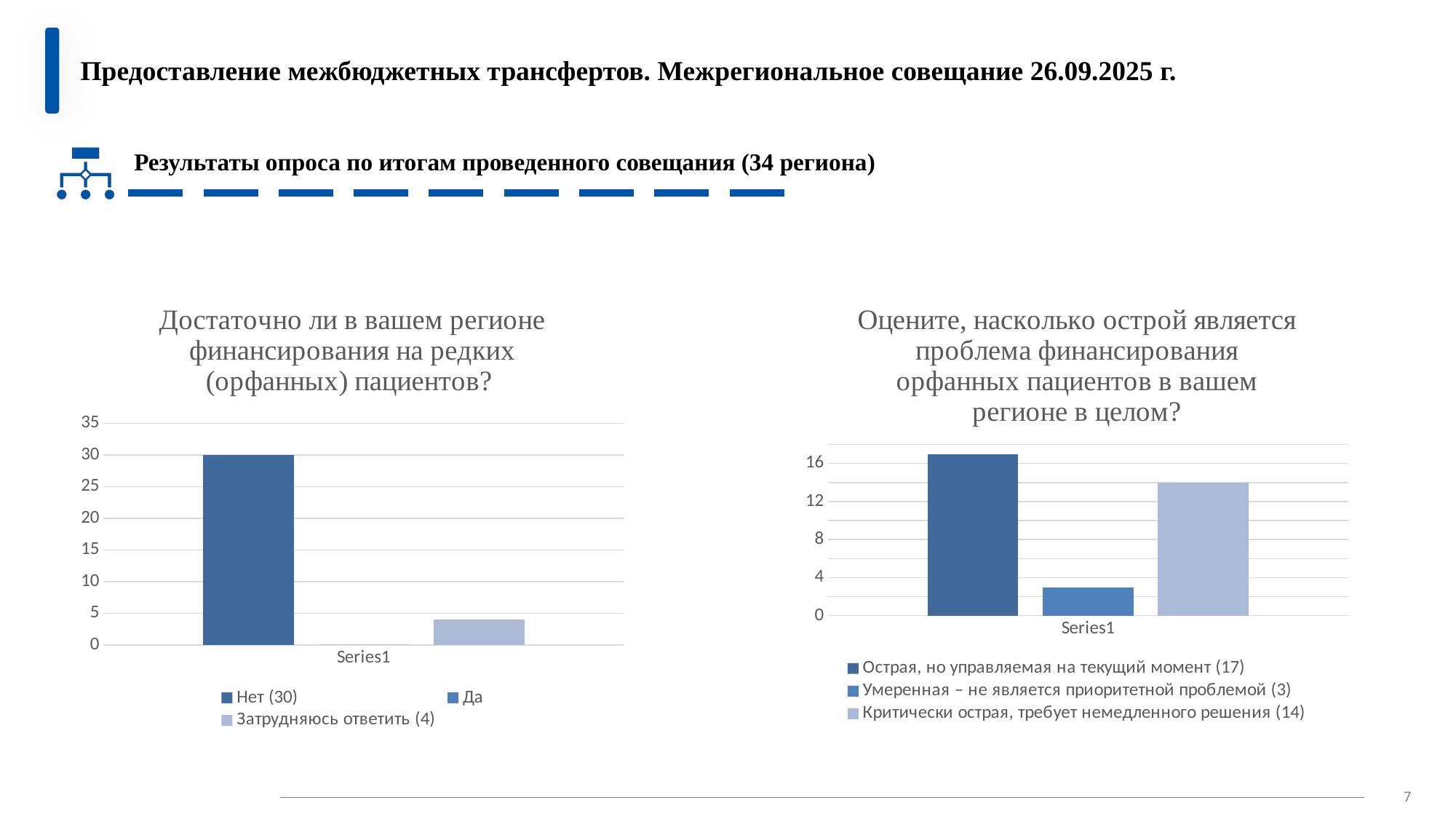
In the left chart ("Достаточно ли в вашем регионе финансирования..."), how many regions answered "Нет"? 30 In the right chart, is the value for "Острая, но управляемая на текущий момент" greater or less than 16? greater In the right chart, how many regions chose "Критически острая, требует немедленного решения"? 14 In the left chart, how many regions answered "Затрудняюсь ответить"? 4 In the right chart, what is the difference between the "Острая, но управляемая" value and the "Умеренная" value? 14 In the left chart, what is the difference between the "Нет" and "Затрудняюсь ответить" values? 26 What type of chart is the left chart? bar chart In the left chart, which answer has the highest value? Нет In the left chart, how many entries does the legend list? 3 In the right chart ("Оцените, насколько острой является проблема..."), how many regions chose "Острая, но управляемая на текущий момент"? 17 In the right chart, which answer has the lowest value? Умеренная – не является приоритетной проблемой In the right chart, which is larger: "Острая, но управляемая на текущий момент" or "Критически острая, требует немедленного решения"? Острая, но управляемая на текущий момент